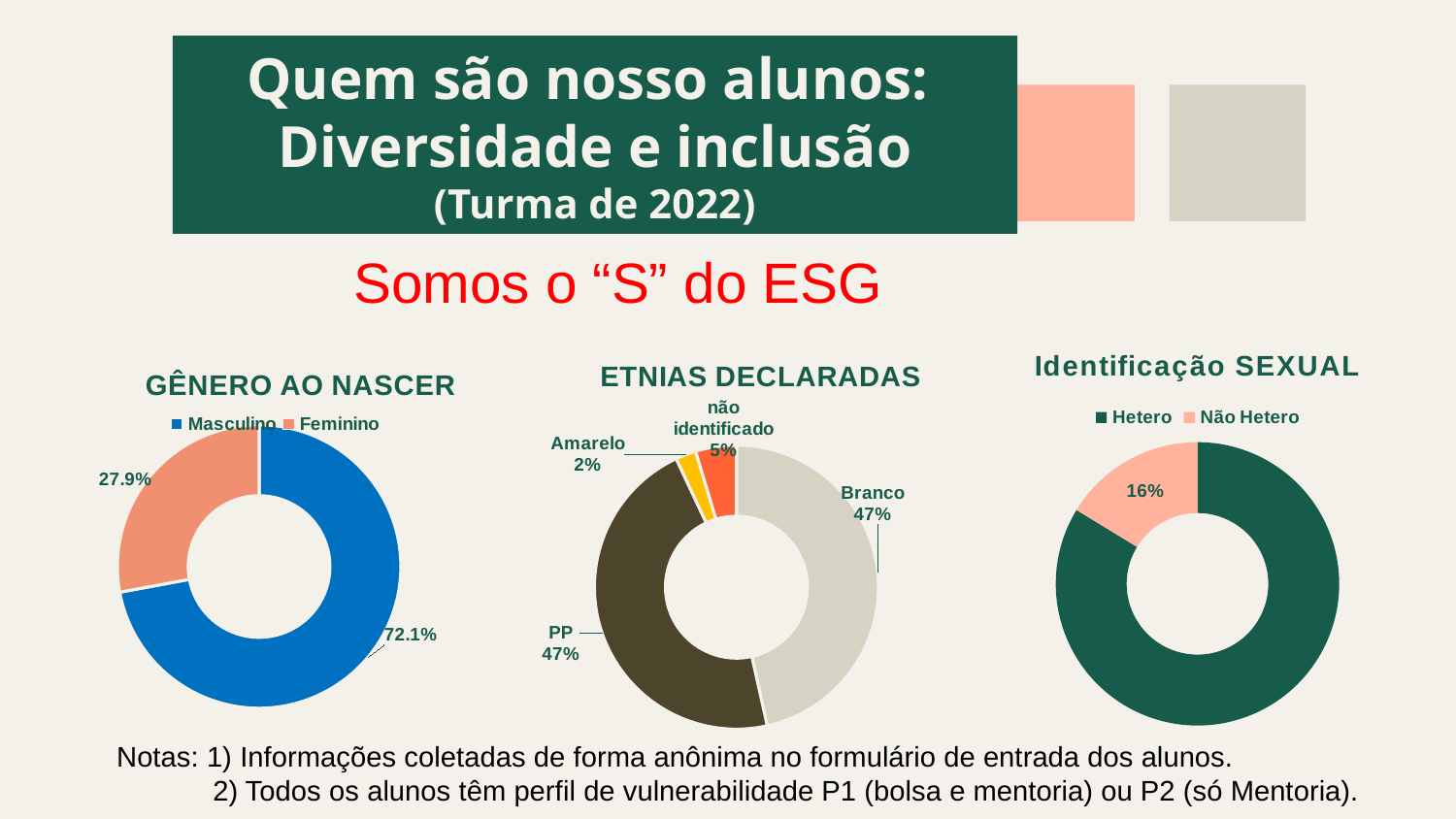
In the GÊNERO AO NASCER chart, which category is the largest? Masculino In the ETNIAS DECLARADAS chart, what is the value for não identificado? 5% How many categories are shown in the ETNIAS DECLARADAS chart? 4 What kind of chart is the GÊNERO AO NASCER chart? Donut (pie) chart In the Identificação SEXUAL chart, which is larger, Hetero or Não Hetero? Hetero In the GÊNERO AO NASCER chart, what is the value for Masculino? 72.1% In the ETNIAS DECLARADAS chart, what is the value for Amarelo? 2% In the ETNIAS DECLARADAS chart, which category has the smallest share? Amarelo In the ETNIAS DECLARADAS chart, what is the value for Branco? 47% In the GÊNERO AO NASCER chart, what is the value for Feminino? 27.9% In the Identificação SEXUAL chart, what is the value for Não Hetero? 16% In the GÊNERO AO NASCER chart, what is the difference between the Masculino and Feminino values? 44.2%